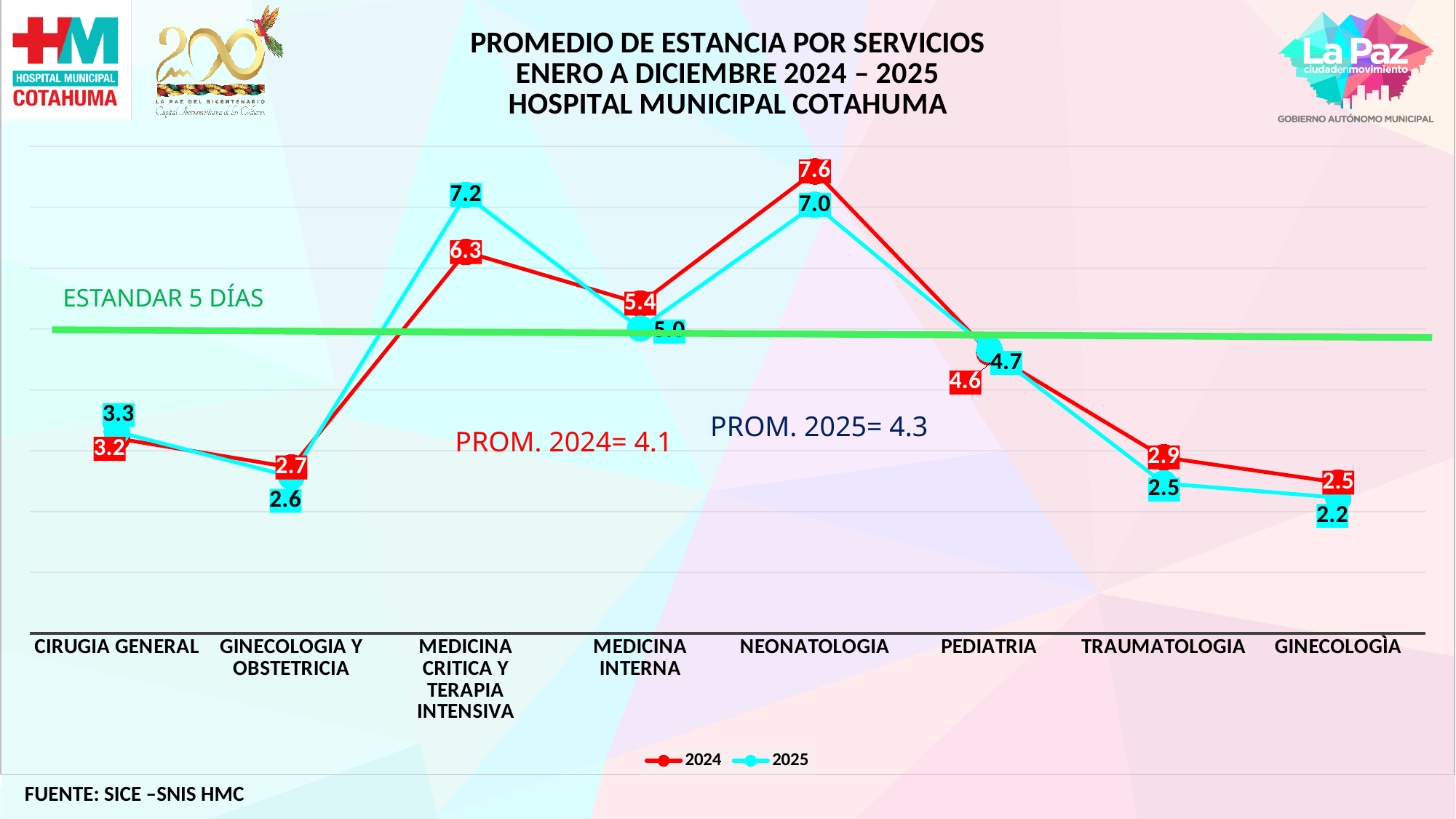
Which service has the lowest 2025 value? GINECOLOGÌA What type of chart is shown on the slide? line chart For TRAUMATOLOGIA, which series has the larger value, 2024 or 2025? 2024 What standard (ESTANDAR) in days is marked by the green line? 5 DÍAS Which service has the highest 2024 value? NEONATOLOGIA What is the 2024 value for NEONATOLOGIA? 7.6 How many service categories are plotted along the x axis? 8 What is the 2025 value for MEDICINA CRITICA Y TERAPIA INTENSIVA? 7.2 How many series does the legend list? 2 What is the difference between the 2025 and 2024 values for MEDICINA CRITICA Y TERAPIA INTENSIVA? 0.9 What is the 2025 value for GINECOLOGÌA? 2.2 What is the average for 2025 stated on the slide (PROM. 2025)? 4.3